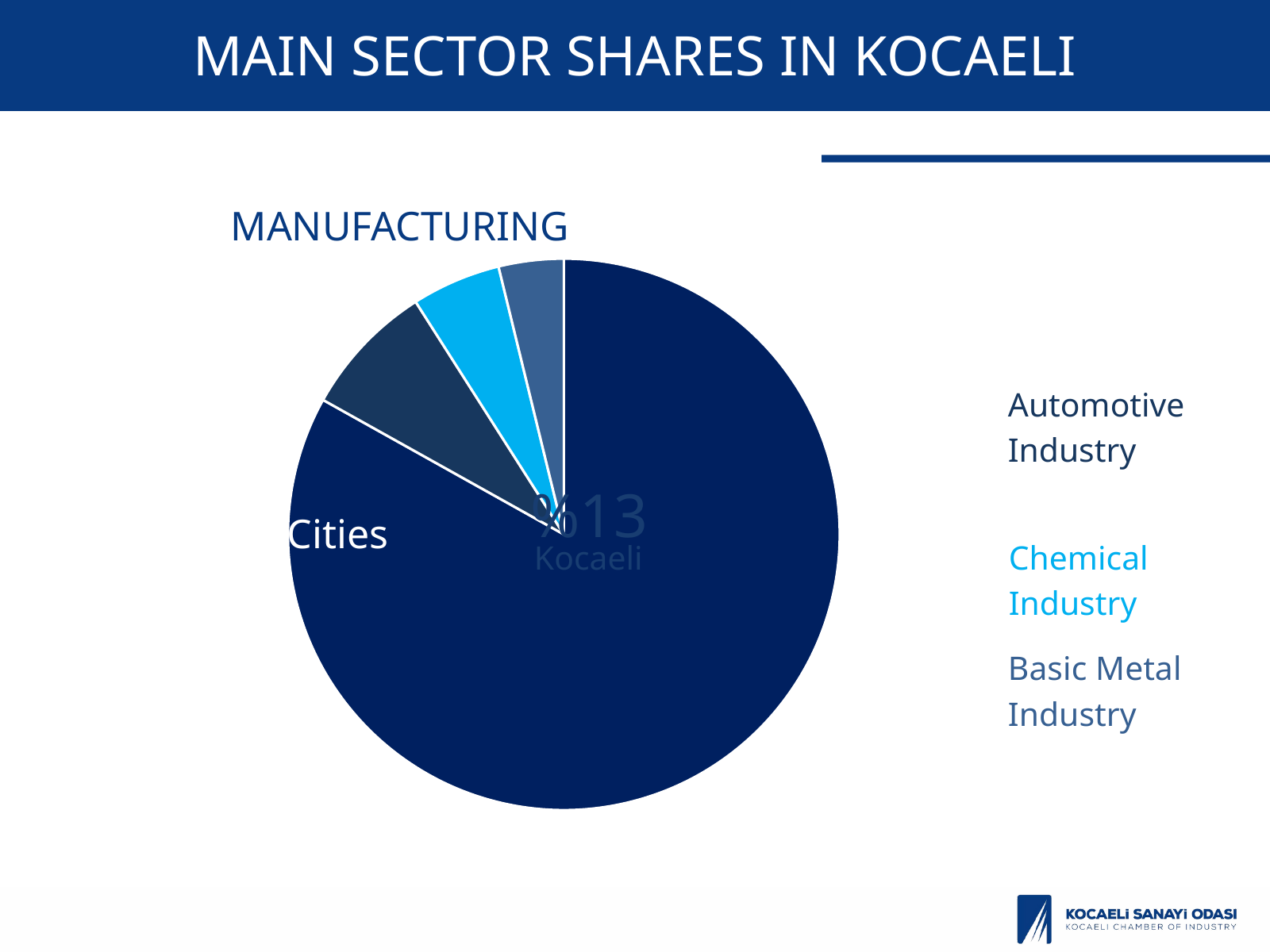
What kind of chart is shown on the slide? pie chart Which slice of the pie chart is the largest? Cities Is the Cities slice greater or less than half of the pie? greater Which slice is larger, Cities or Chemical Industry? Cities Which slice of the pie chart is the smallest? Basic Metal Industry What colour is the Chemical Industry slice in the pie chart? light blue Which slice is larger, Automotive Industry or Basic Metal Industry? Automotive Industry What is the title of the slide containing the pie chart? MAIN SECTOR SHARES IN KOCAELI How many slices does the pie chart have? 4